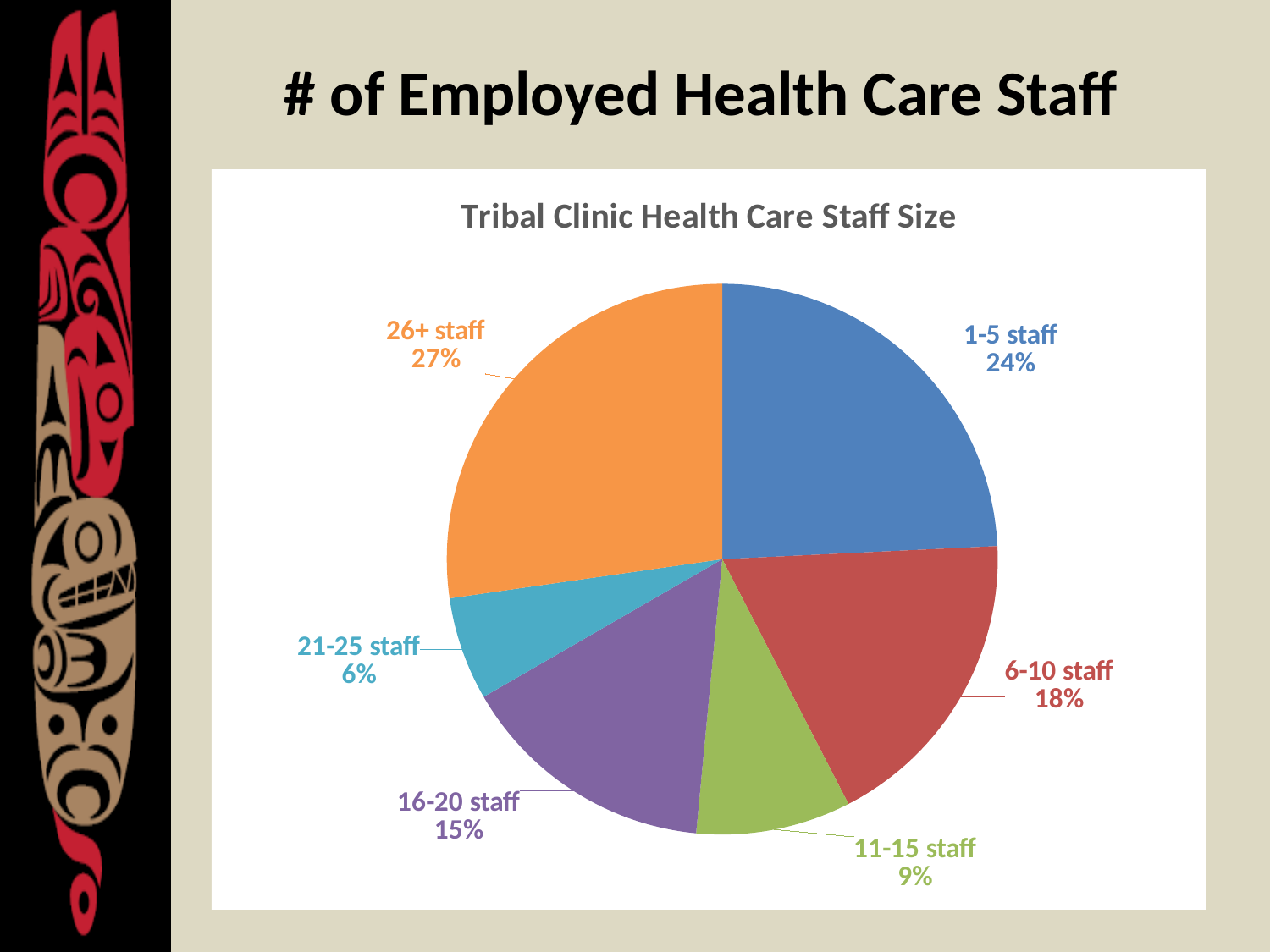
What is the difference in percentage points between the 6-10 staff slice and the 11-15 staff slice? 9% How many categories are shown in the pie chart? 6 What share of the pie does the 1-5 staff slice represent? 24% What kind of chart is shown on the slide? Pie chart Which is larger, the 16-20 staff slice or the 11-15 staff slice? 16-20 staff What is the title of the chart? Tribal Clinic Health Care Staff Size Which category has the smallest share of the pie? 21-25 staff What is the difference in percentage points between the 26+ staff slice and the 1-5 staff slice? 3% What percentage is shown for the 16-20 staff category? 15% What percentage is shown for the 6-10 staff category? 18% What colour is the 21-25 staff slice? Teal Which category has the largest share of the pie? 26+ staff